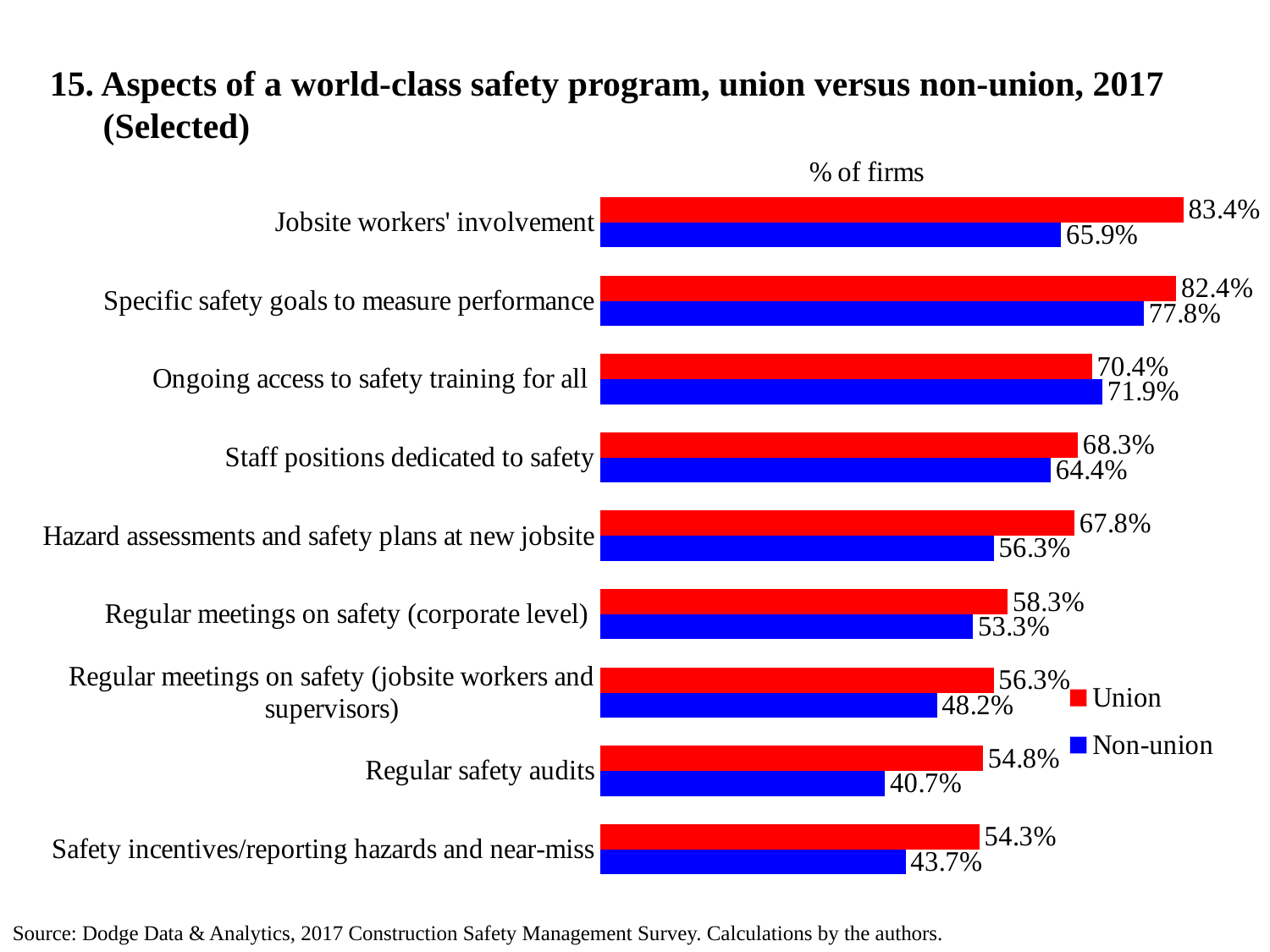
What percentage of non-union firms report regular safety audits? 40.7% What is the difference between the union and non-union values for jobsite workers' involvement? 17.5% What percentage of union firms report jobsite workers' involvement? 83.4% Which colour represents non-union firms in the chart? Blue What is the non-union value for ongoing access to safety training for all? 71.9% Which aspect has the lowest non-union percentage? Regular safety audits For ongoing access to safety training for all, which is larger: the union or non-union value? Non-union What type of chart is shown on the slide? Bar chart What is the difference between the union and non-union values for regular safety audits? 14.1% How many series does the legend list? 2 How many aspects of a safety program are shown on the chart? 9 Which aspect has the highest union percentage? Jobsite workers' involvement